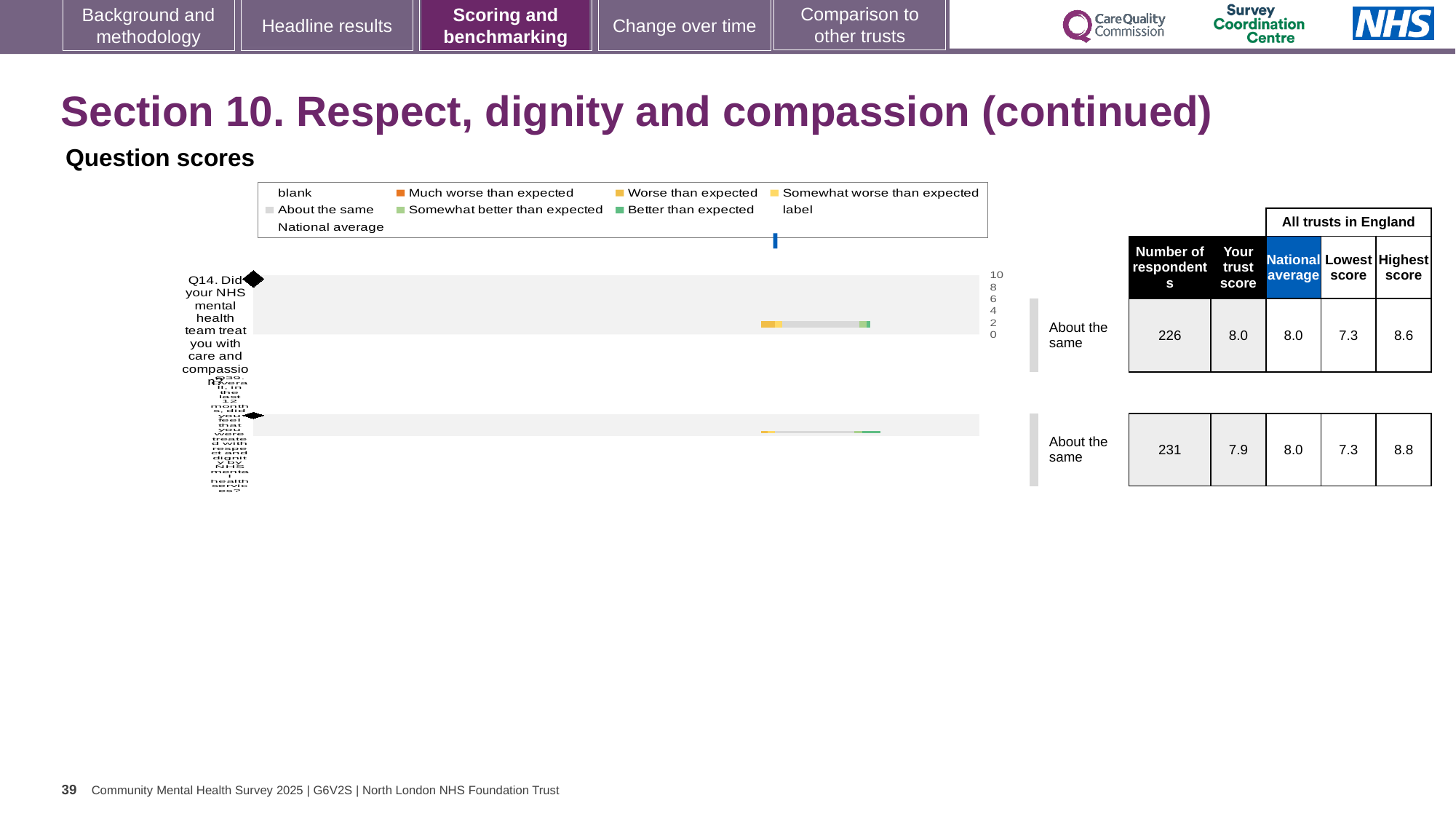
How many respondents are listed for Q39? 231 What is the difference in the number of respondents between Q39 and Q14? 5 What is the lowest score across all trusts in England for Q14? 7.3 In the table beside the chart, what is the trust score for Q14? 8.0 What is the highest value shown on the chart's score axis? 10 What is the highest score across all trusts in England for Q39? 8.8 How many questions are plotted in the Question scores chart? 2 In the table beside the chart, what is the trust score for Q39? 7.9 What benchmark category is shown next to the Q14 bar? About the same What kind of chart is shown under 'Question scores'? bar chart How many respondents are listed for Q14? 226 Which question has more respondents, Q14 or Q39? Q39